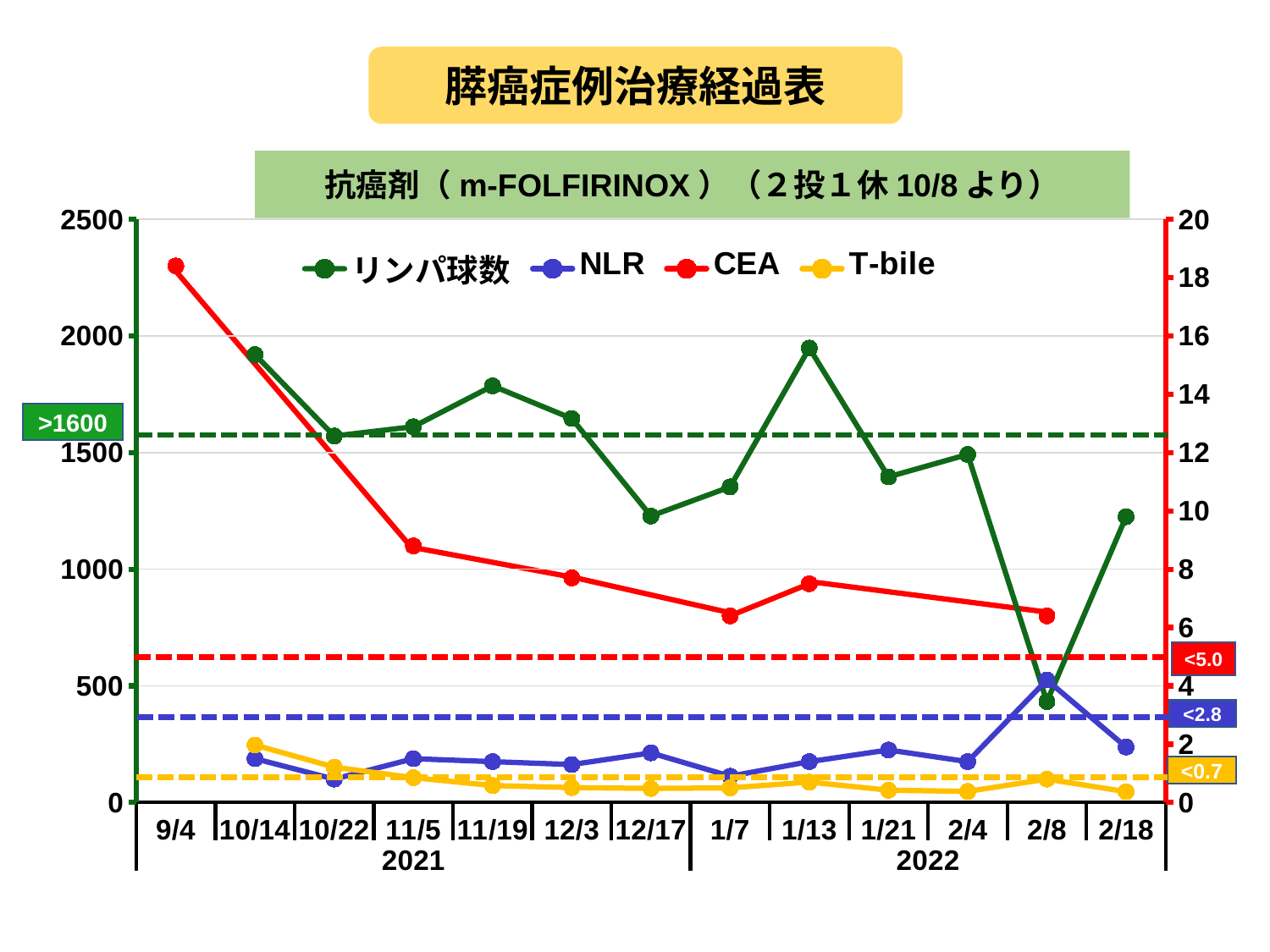
Is the CEA value on 9/4 greater or less than 16 on the right axis? greater Is the リンパ球数 value on 2/8 greater or less than 1000? less On which date is the NLR value highest? 2/8 On which date is the リンパ球数 value lowest? 2/8 Does the CEA series generally rise or fall from 9/4 to 2/8? fall What kind of chart is shown on the slide? line chart How many series does the legend list? 4 How many dates are plotted along the x axis? 13 Which is larger, the CEA value on 9/4 or on 11/5? 9/4 Is the リンパ球数 value on 10/14 greater or less than 1500? greater What is the title of the slide? 膵癌症例治療経過表 On which date is the CEA value highest? 9/4